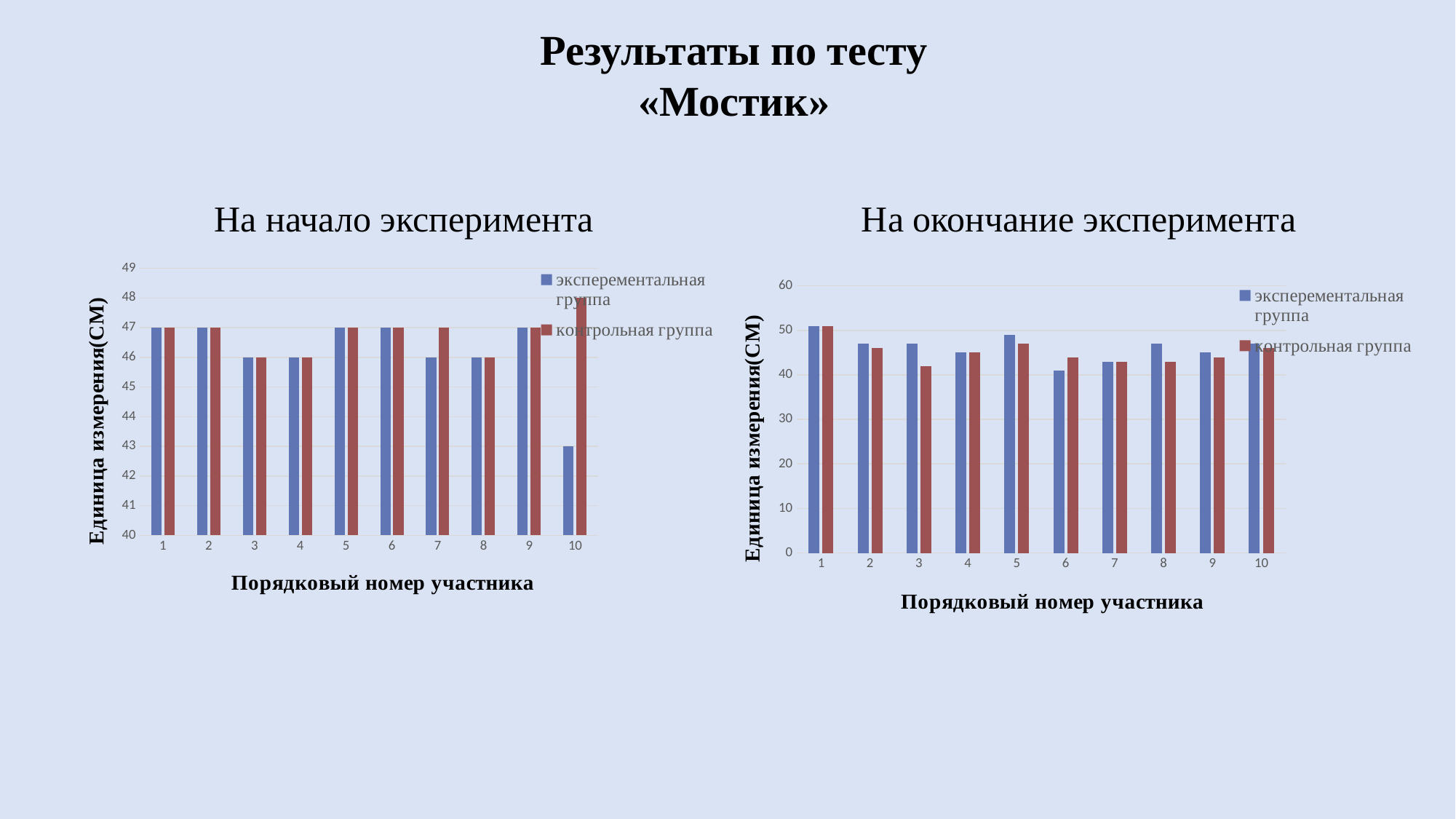
On the chart titled «На начало эксперимента», which participant has the highest value in the контрольная группа series? 10 On the chart titled «На начало эксперимента», what is the value for the экспереметальная группа series for participant 10? 43 On the chart titled «На окончание эксперимента», is the value for the контрольная группа series for participant 8 greater or less than 50? less On the chart titled «На начало эксперимента», what is the value for the контрольная группа series for participant 7? 47 On the chart titled «На окончание эксперимента», how many participants are shown on the x axis? 10 What kind of chart is the chart titled «На начало эксперимента»? bar chart On the chart titled «На окончание эксперимента», how many series does the legend list? 2 On the chart titled «На начало эксперимента», which participant has the lowest value in the экспереметальная группа series? 10 On the chart titled «На начало эксперимента», what is the value for the контрольная группа series for participant 10? 48 On the chart titled «На начало эксперимента», for participant 7, which series has the larger value? контрольная группа On the chart titled «На начало эксперимента», what is the difference between the контрольная группа and экспереметальная группа values for participant 10? 5